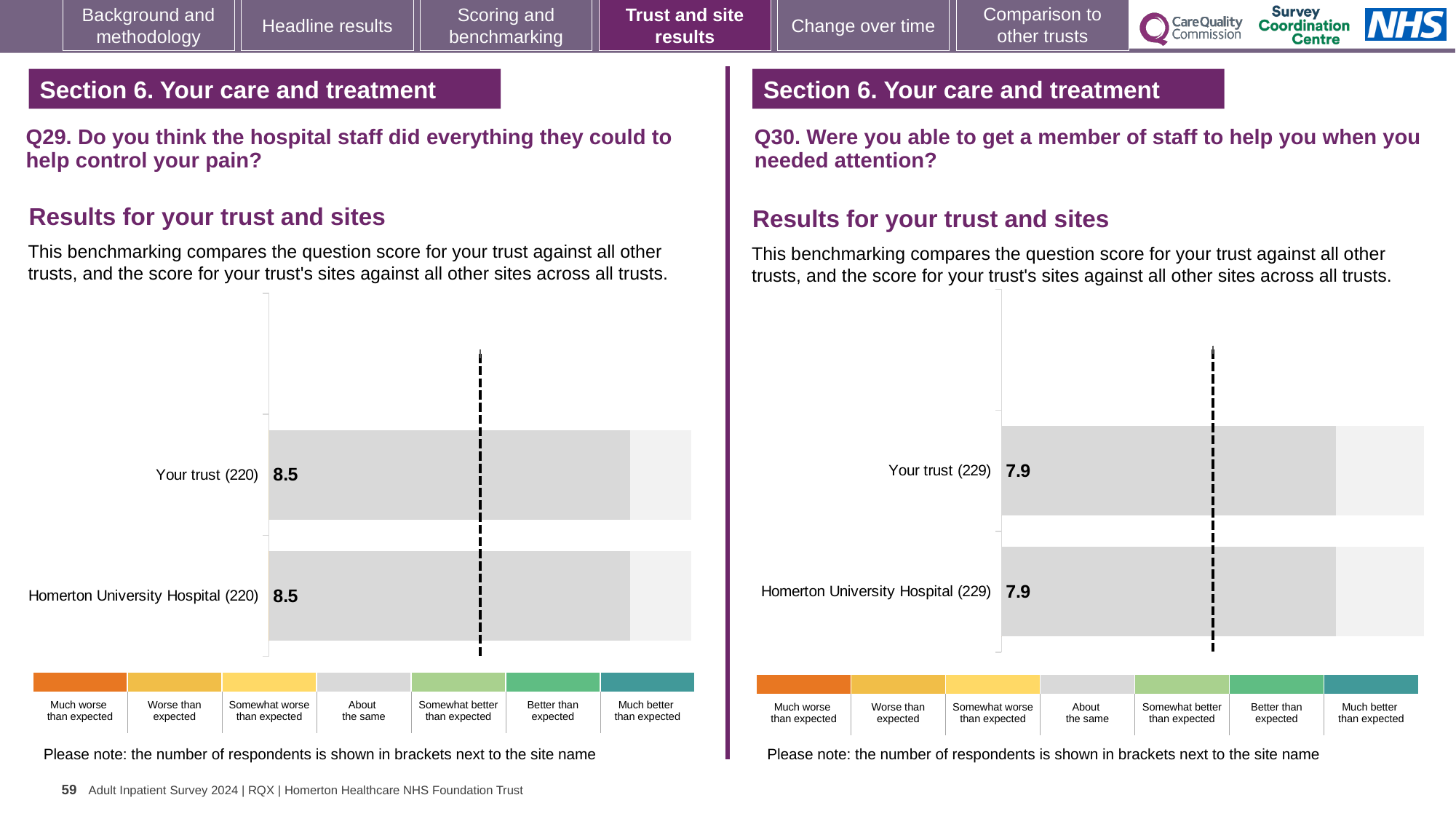
In the Q29 chart on the left, how many respondents are shown in brackets next to Homerton University Hospital? 220 How many bars are plotted in the Q29 chart on the left? 2 How many categories does the colour key below the Q30 chart on the right list? 7 How many bars are plotted in the Q30 chart on the right? 2 In the Q30 chart on the right, what is the score for Homerton University Hospital? 7.9 In the Q29 chart on the left, what is the difference between the Your trust score and the Homerton University Hospital score? 0 What is the difference between the Your trust score in the Q29 chart and the Your trust score in the Q30 chart? 0.6 In the Q30 chart on the right, what is the score for Your trust? 7.9 In the Q30 chart on the right, how many respondents are shown in brackets next to Your trust? 229 In the Q29 chart on the left, what is the score for Homerton University Hospital? 8.5 What kind of chart is used for the Q29 results on the left? Bar chart In the Q29 chart on the left, what is the score for Your trust? 8.5